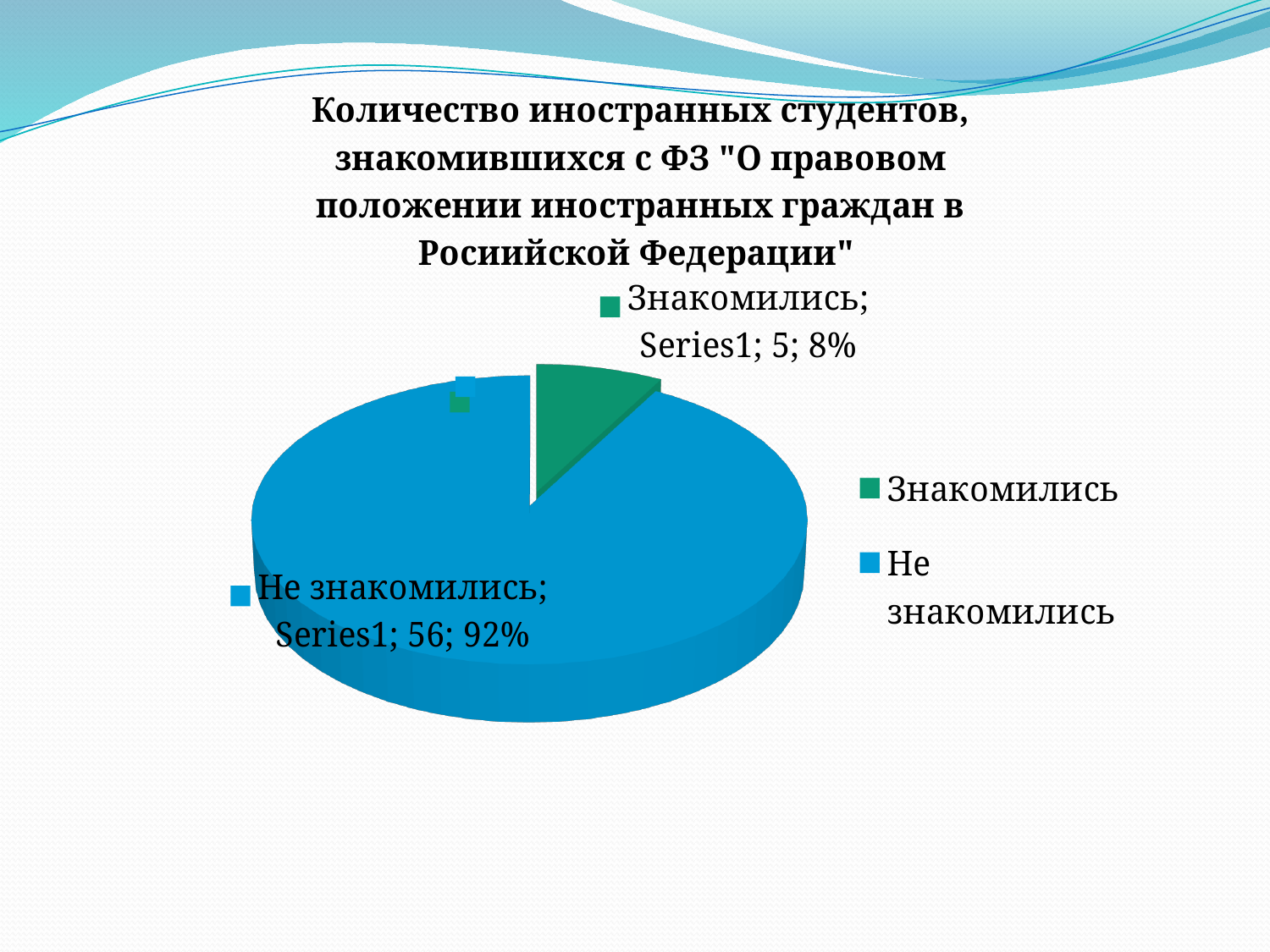
What is the value for "Знакомились"? 5 Which category has the largest slice? Не знакомились What kind of chart is shown on the slide? pie chart How many categories does the pie chart have? 2 What is the value for "Не знакомились"? 56 What share of the pie does "Не знакомились" represent? 92% Which is larger, the value for "Знакомились" or "Не знакомились"? Не знакомились What share of the pie does "Знакомились" represent? 8% What is the total of the two values shown in the pie chart? 61 Which category has the smallest slice? Знакомились What is the difference between the values for "Не знакомились" and "Знакомились"? 51 What colour is the "Знакомились" slice? green